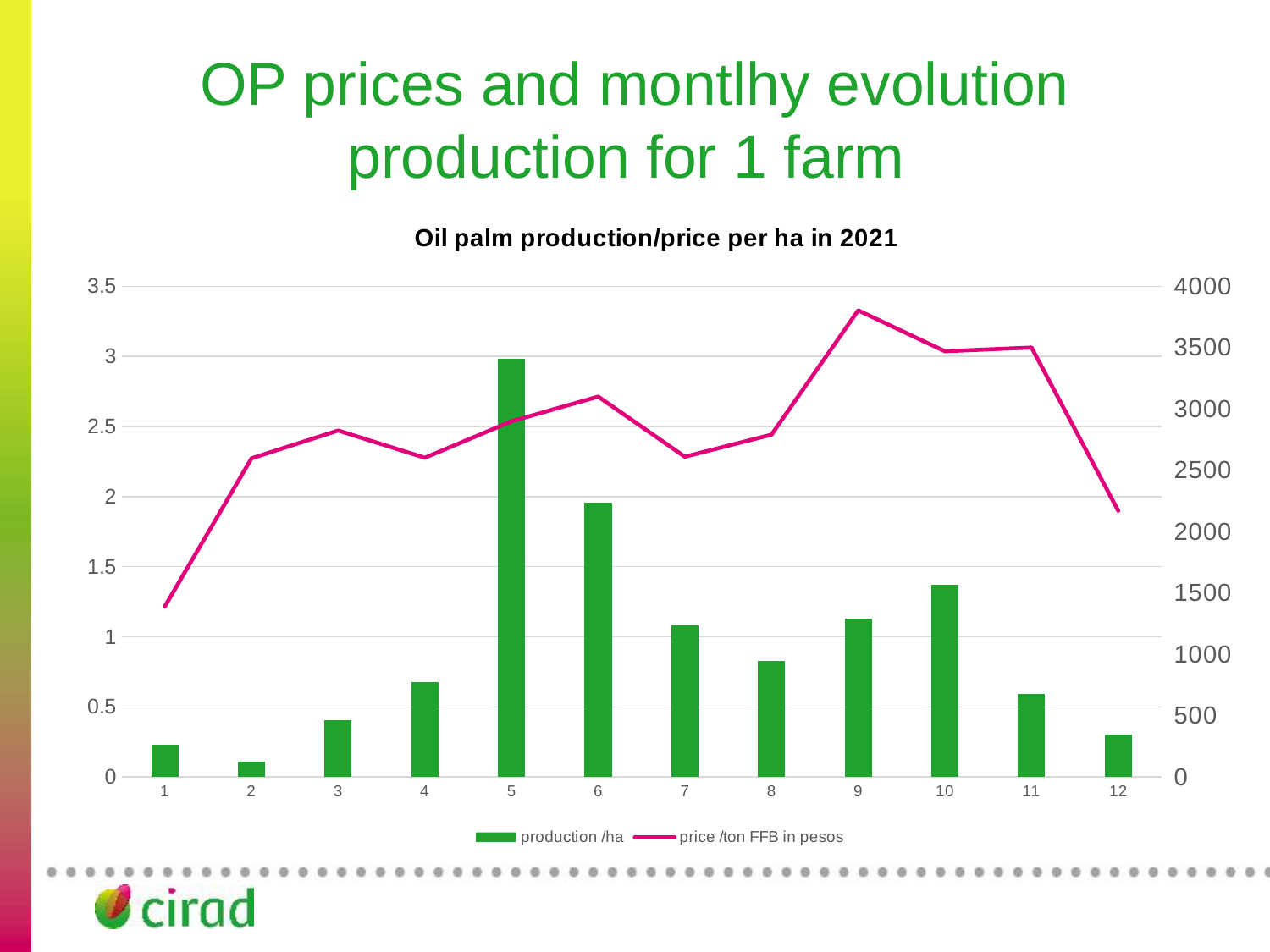
Is the price /ton FFB in pesos for month 12 greater or less than 2500? less Is the price /ton FFB in pesos for month 9 greater or less than 3500? greater In which month is production /ha highest? 5 What kind of chart is this? Combined bar and line chart Does the price /ton FFB in pesos rise or fall from month 9 to month 12? fall Which month has higher production /ha, month 6 or month 7? 6 Is the production /ha value for month 5 greater or less than 2.5? greater How many months (categories) are shown on the x axis? 12 What is the title of the chart? Oil palm production/price per ha in 2021 In which month is production /ha lowest? 2 In which month is the price /ton FFB in pesos highest? 9 How many series does the legend list? 2